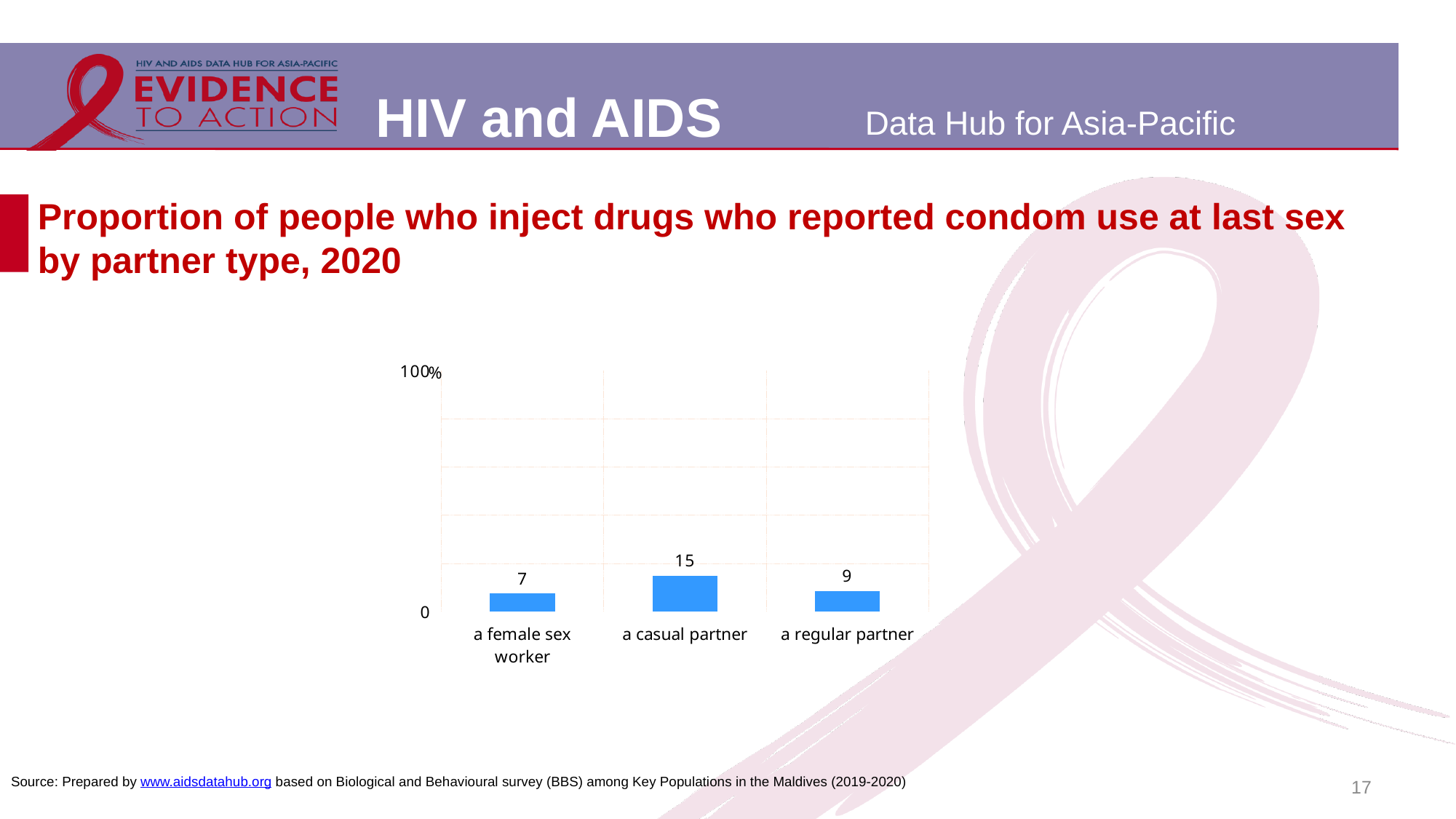
What is the value for a female sex worker? 7 Which is larger, the value for a casual partner or the value for a regular partner? a casual partner What is the difference between the values for a casual partner and a female sex worker? 8 What is the value for a casual partner? 15 Which partner type has the highest value? a casual partner What kind of chart is shown on the slide? bar chart What is the value for a regular partner? 9 What year does the chart title refer to? 2020 Which partner type has the lowest value? a female sex worker How many partner types are shown on the chart? 3 What is the difference between the values for a regular partner and a female sex worker? 2 What is the maximum value shown on the vertical axis? 100%